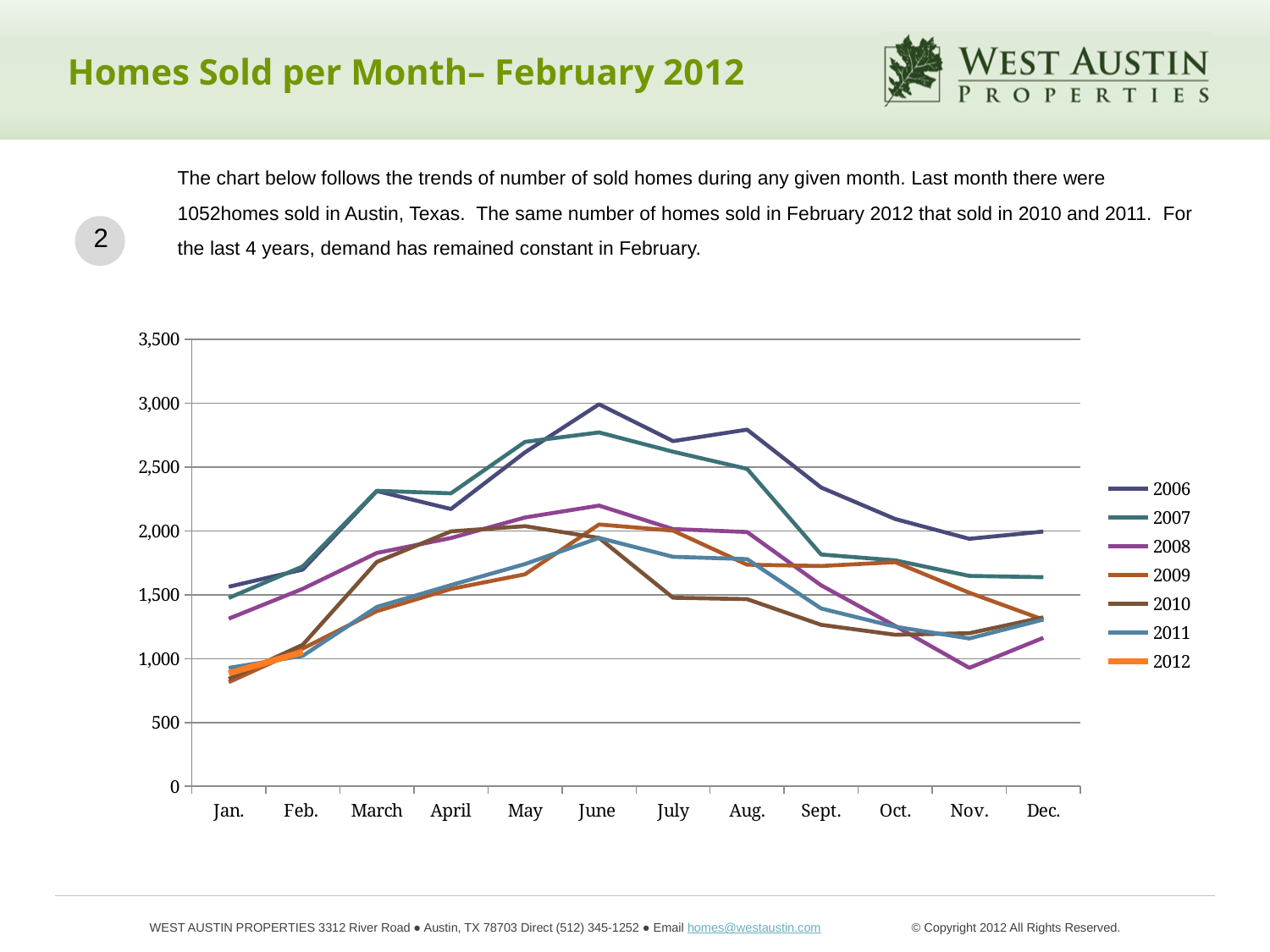
What kind of chart is shown on the slide? line chart In which month does the 2006 series reach its highest value? June Is the value for 2009 in Aug. greater or less than 1,500? greater Which series in the legend is plotted only for Jan. and Feb.? 2012 How many months are shown along the x axis of the chart? 12 How many series does the chart's legend list? 7 Does the 2006 series rise or fall from Jan. to June? rise Is the value for 2008 in Nov. greater or less than 1,000? less In which month does the 2008 series reach its lowest value? Nov. Is the value for 2006 in June greater or less than 2,500? greater Which series reaches the highest value on the chart? 2006 Which is larger in Sept., the value for 2006 or the value for 2010? 2006